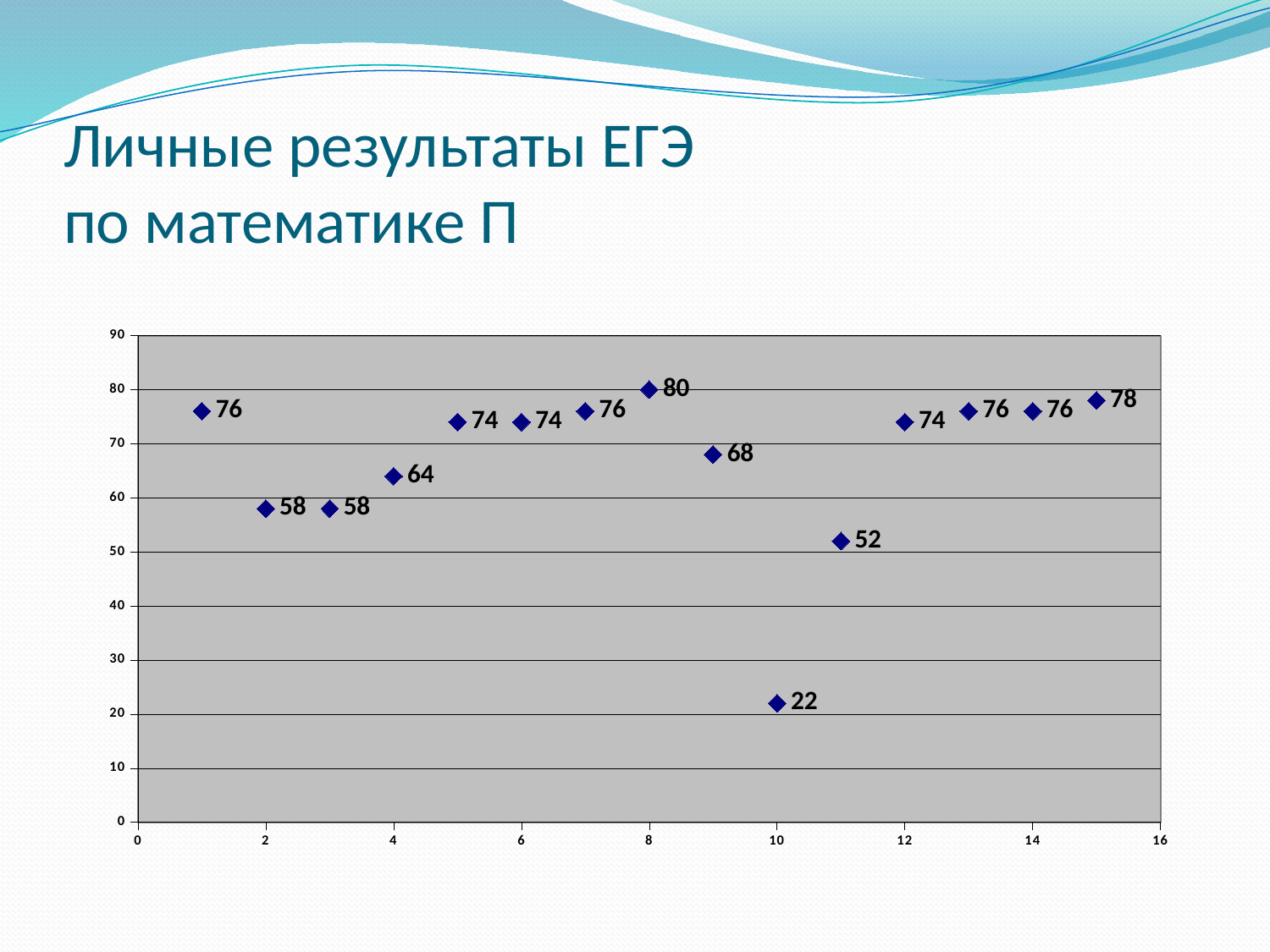
What is the value of the data point at x = 10? 22 What is the difference between the highest value (80) and the lowest value (22)? 58 What is the value of the data point at x = 4? 64 How many data points are plotted on the chart? 15 Which is larger: the value at x = 9 or the value at x = 11? the value at x = 9 (68) What is the lowest value plotted on the chart? 22 What is the difference between the value at x = 1 and the value at x = 2? 18 What type of chart is shown on the slide? scatter chart What is the highest value plotted on the chart? 80 What is the value of the data point at x = 15? 78 What is the title of the slide containing the chart? Личные результаты ЕГЭ по математике П What is the value of the data point at x = 8? 80